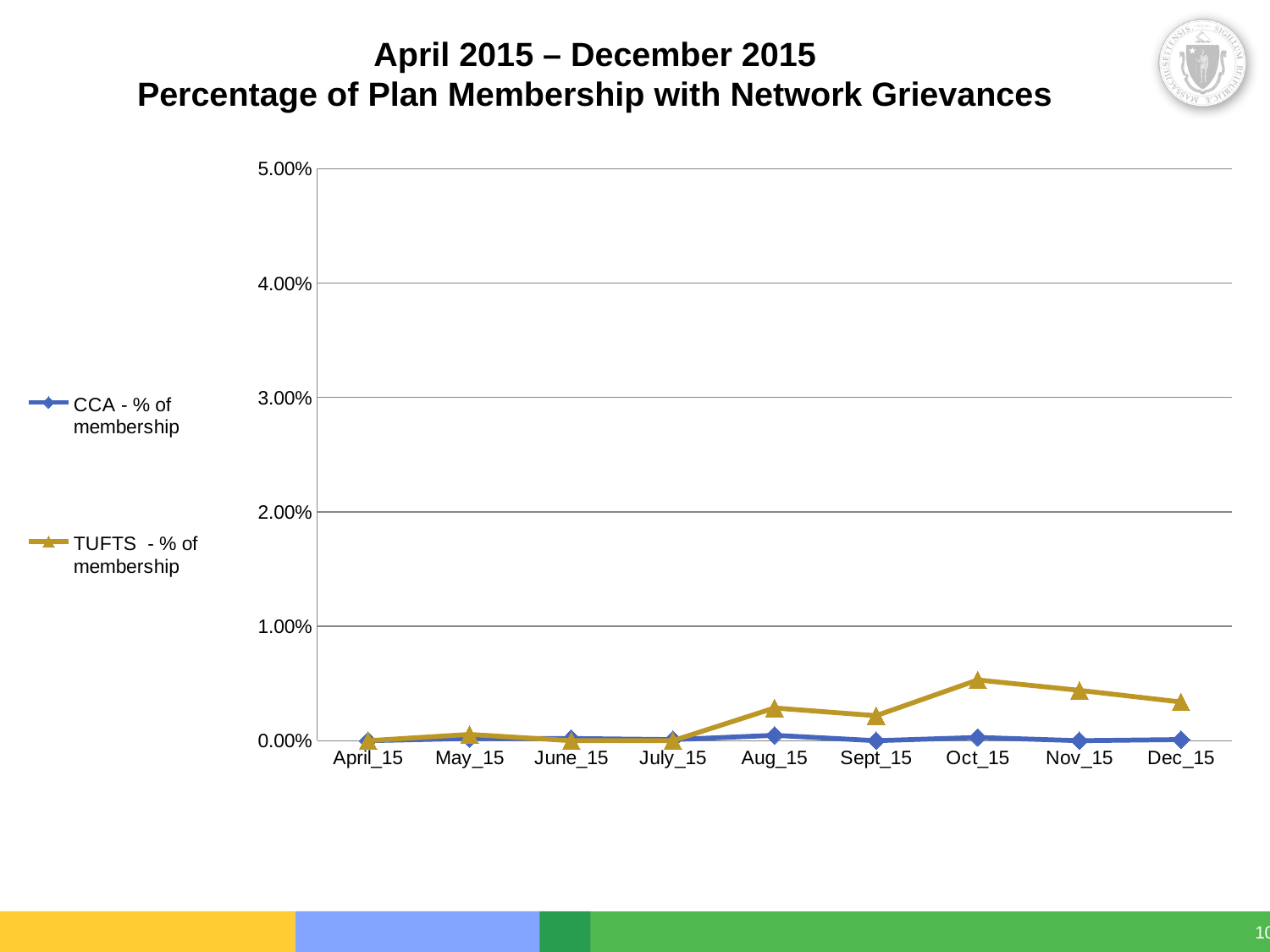
How many months are plotted along the x axis? 9 Is the value for CCA - % of membership in Aug_15 greater or less than 1.00%? less What is the title of the chart? April 2015 – December 2015 Percentage of Plan Membership with Network Grievances What kind of chart is shown on the slide? line chart Does the TUFTS - % of membership series rise or fall from Oct_15 to Dec_15? fall Is the value for TUFTS - % of membership in Oct_15 greater or less than 1.00%? less What is the highest value shown on the y axis? 5.00% Does the TUFTS - % of membership series rise or fall from July_15 to Aug_15? rise In Oct_15, which series has the larger value, CCA - % of membership or TUFTS - % of membership? TUFTS - % of membership In which month does the TUFTS - % of membership series reach its highest value? Oct_15 In Nov_15, which series has the larger value, CCA - % of membership or TUFTS - % of membership? TUFTS - % of membership How many series does the legend list? 2